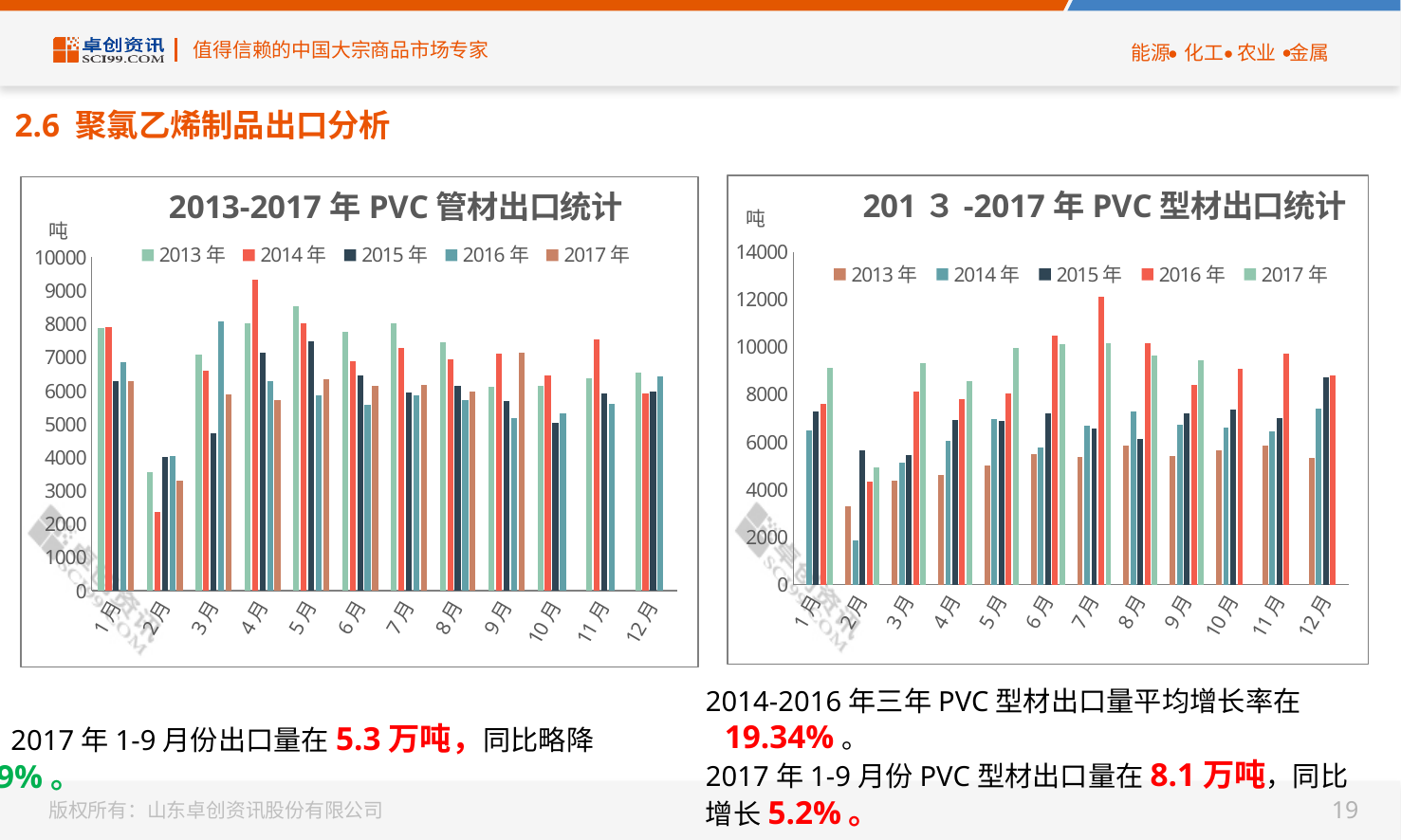
In the left chart (PVC管材出口统计), is the value for 2014年 in 4月 greater or less than 9000? greater What kind of chart is the left chart titled 2013-2017年PVC管材出口统计? bar chart In the left chart (PVC管材出口统计), is the value for 2014年 in 2月 greater or less than 3000? less In the left chart (PVC管材出口统计), how many series does the legend list? 5 In the left chart (PVC管材出口统计), which month and year has the highest bar? 2014年 4月 In the right chart (PVC型材出口统计), which is larger in 2月: the 2013年 bar or the 2014年 bar? 2013年 In the right chart (PVC型材出口统计), which month and year has the highest bar? 2016年 7月 What unit is shown on the y axis of the left chart (PVC管材出口统计)? 吨 In the right chart (PVC型材出口统计), how many month categories are shown on the x axis? 12 In the left chart (PVC管材出口统计), which is larger in 2月: the 2013年 bar or the 2014年 bar? 2013年